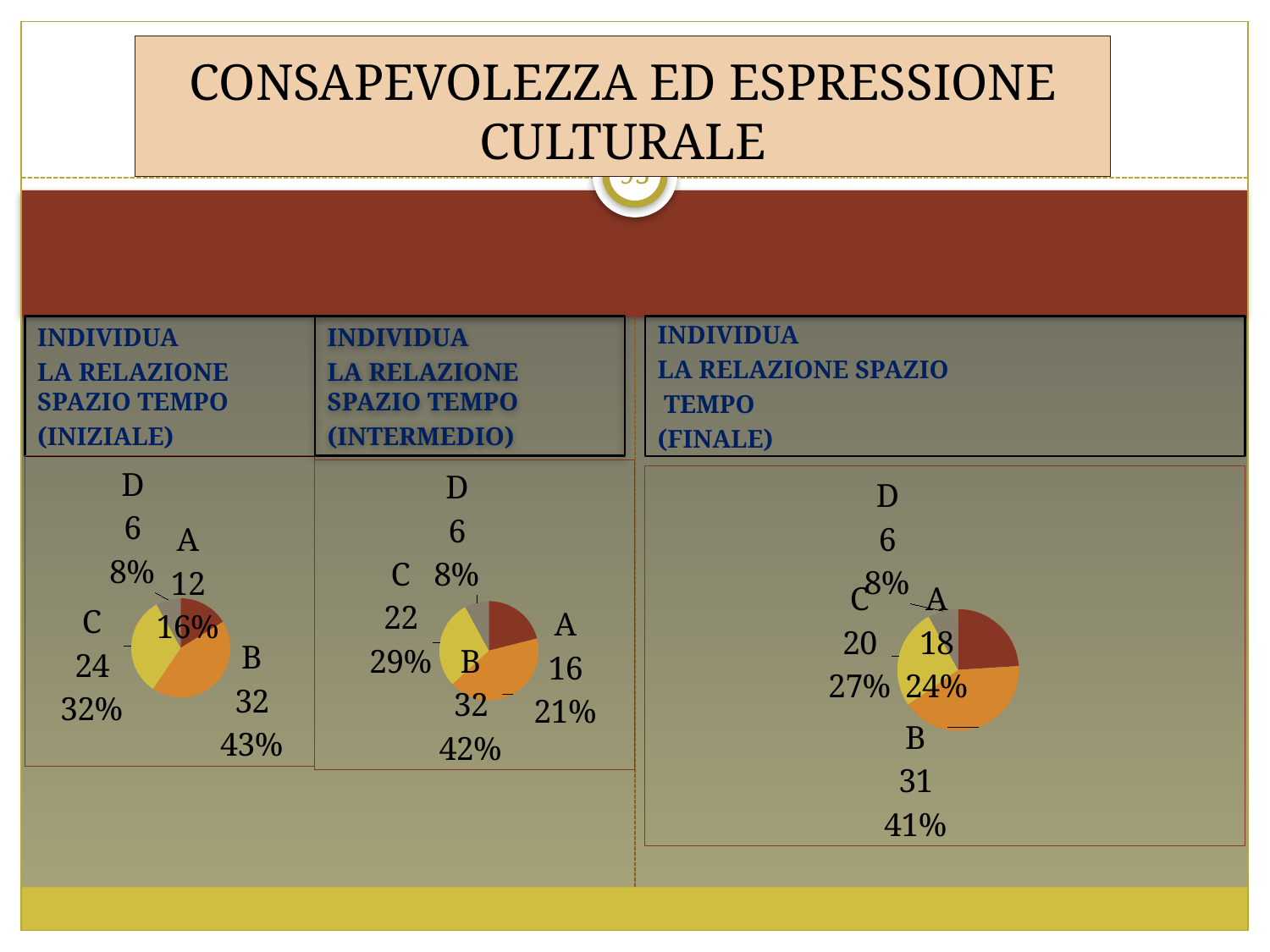
How many categories does the INIZIALE pie chart (left) show? 4 In the INTERMEDIO pie chart (middle), what percentage share does category B have? 42% In the FINALE pie chart (right), what value is shown for category C? 20 What type of chart is used in the FINALE panel on the right? Pie chart In the INTERMEDIO pie chart (middle), what value is shown for category A? 16 In the FINALE pie chart (right), what percentage share does category A have? 24% In the FINALE pie chart (right), which is larger, the value for C or the value for A? C In the INIZIALE pie chart (left), what value is shown for category B? 32 In the INIZIALE pie chart (left), what percentage share does category C have? 32% In the INTERMEDIO pie chart (middle), which category has the largest slice? B In the FINALE pie chart (right), what is the difference between the values for B and A? 13 In the INIZIALE pie chart (left), which category has the smallest slice? D